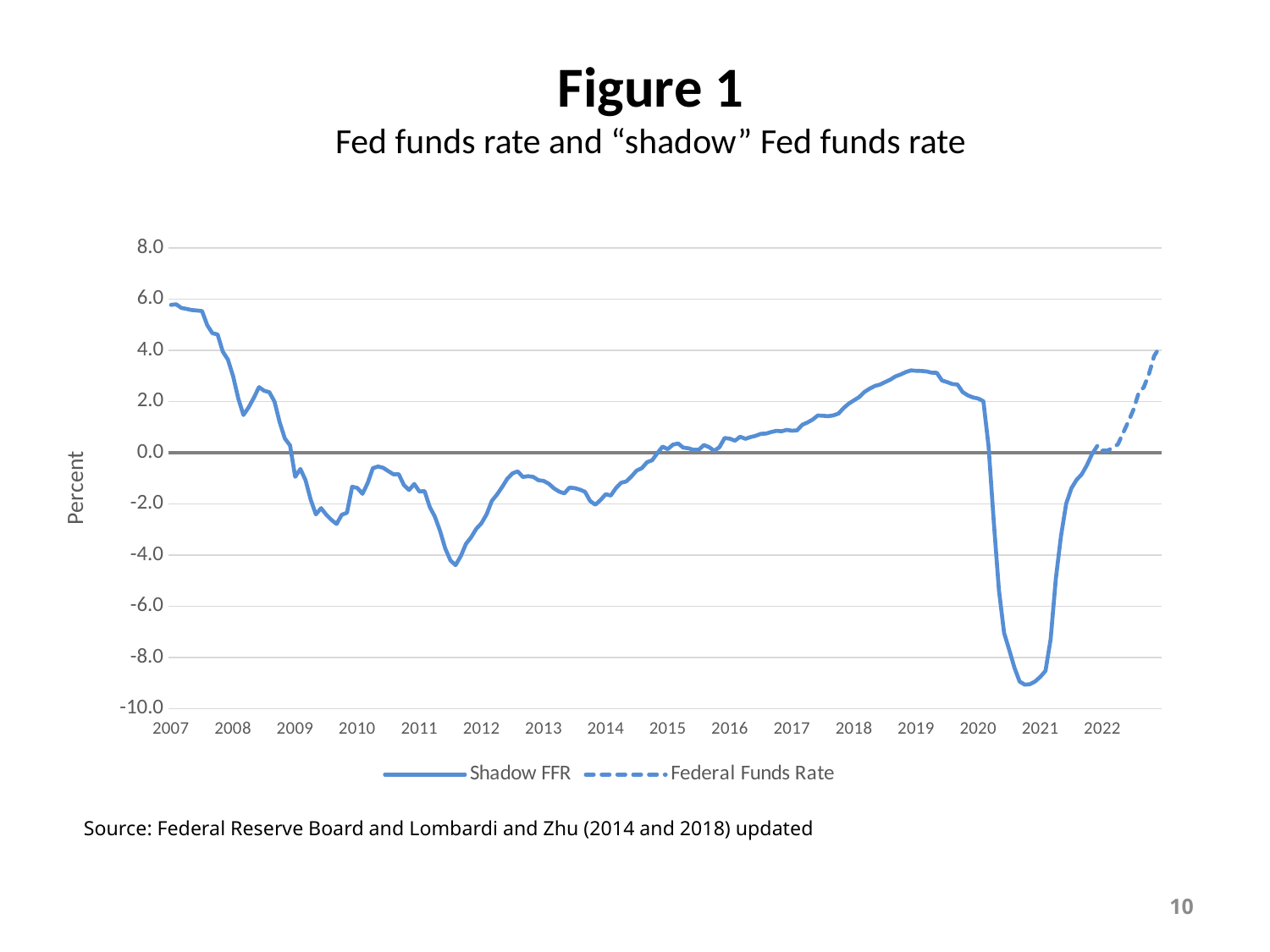
Does the Federal Funds Rate rise or fall during 2022? rise In which year does the Shadow FFR reach its lowest value? 2020 Is the lowest value of the Shadow FFR greater or less than -8.0? less Is the Shadow FFR at the end of 2011 greater or less than -2.0? less Is the Shadow FFR at the start of 2007 greater or less than 4.0? greater How many series does the legend list? 2 What is the label on the vertical axis? Percent Does the Shadow FFR rise or fall between 2007 and 2009? fall What kind of chart is shown on the slide? line chart Which series is drawn with a dashed line? Federal Funds Rate What are the two series named in the legend? Shadow FFR and Federal Funds Rate